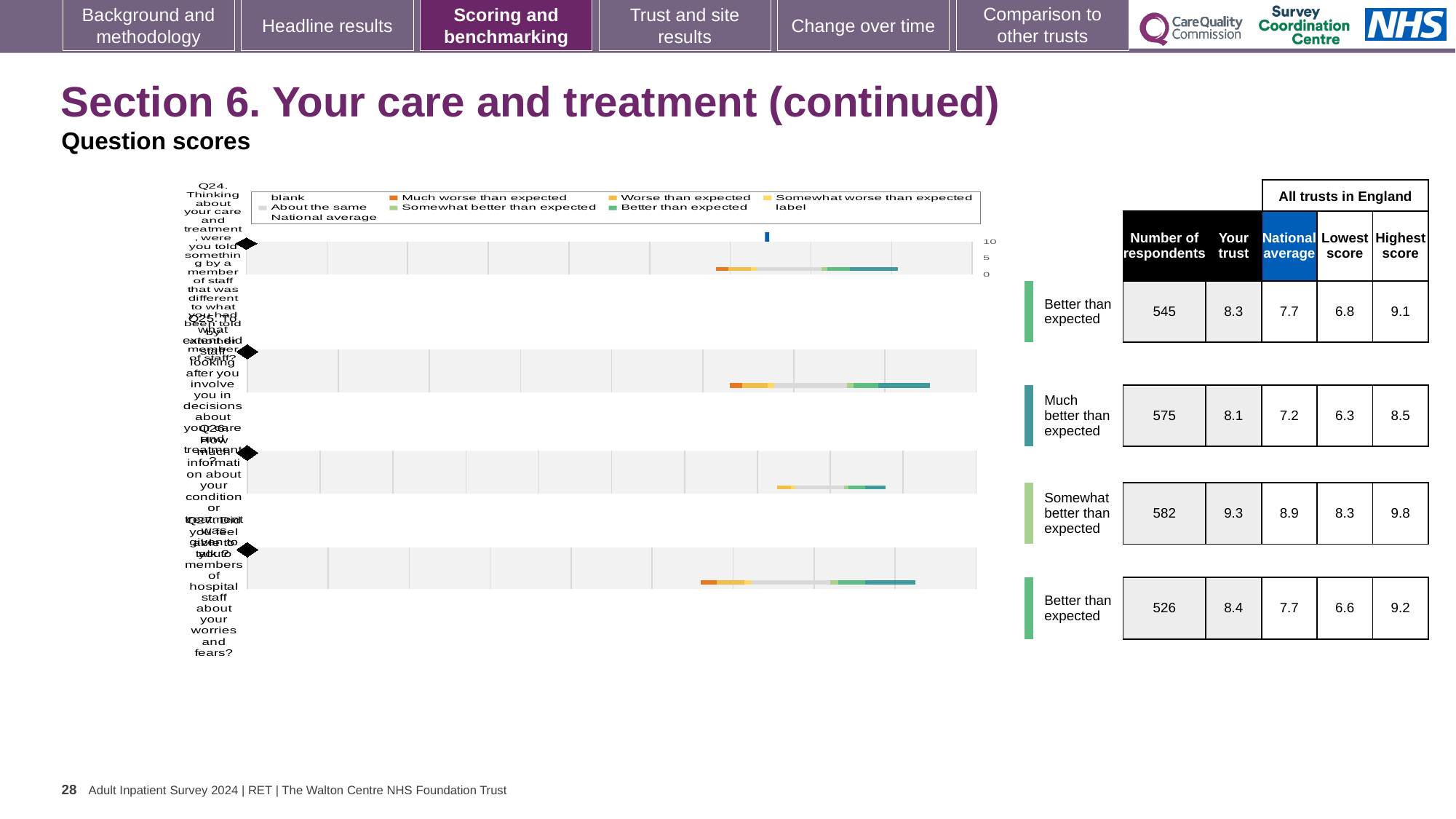
Which row has the lowest number of respondents? the bottom row, 526 For the second chart from the top, what is the difference between the 'Your trust' score and the national average? 0.9 What heading appears above the National average, Lowest score and Highest score columns in the table? All trusts in England How many question charts (rows) are shown on the slide? 4 What benchmark rating is given to the second chart from the top? Much better than expected For the second chart from the top, how many respondents are listed in the table? 575 For the top chart (Q24), which is larger: the 'Your trust' score or the national average? Your trust What kind of chart is used to show the question scores on this slide? bar chart For the top chart (Q24), what is the 'Your trust' score shown in the table? 8.3 Which row has the highest 'Your trust' score? the third row (Somewhat better than expected), 9.3 For the third chart from the top, what is the national average score? 8.9 For the bottom chart, what is the highest score among all trusts in England? 9.2